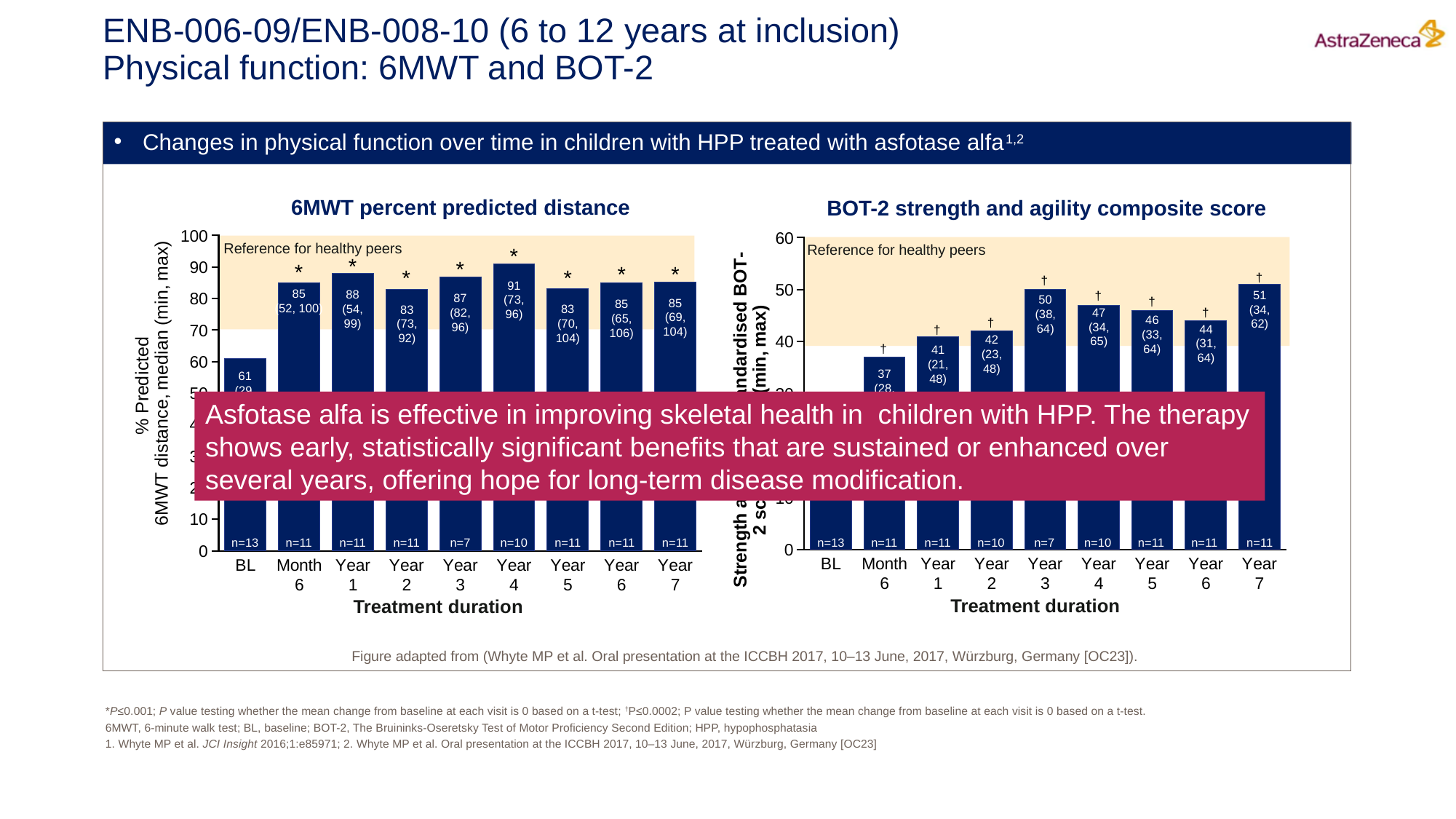
In the 6MWT percent predicted distance chart, which time point has the lowest median value? BL In the 6MWT percent predicted distance chart, what is the difference between the median at Year 4 and the median at baseline (BL)? 30 In the BOT-2 strength and agility composite score chart, which is larger, the median at Year 3 or the median at Year 6? Year 3 How many time points are shown on the x axis of the 6MWT percent predicted distance chart? 9 In the 6MWT percent predicted distance chart, what is the median value at Year 4? 91 In the BOT-2 strength and agility composite score chart, what is the median value at Year 7? 51 In the 6MWT percent predicted distance chart, what is the median value at baseline (BL)? 61 In the BOT-2 strength and agility composite score chart, what is the difference between the median at Year 3 and the median at Month 6? 13 In the 6MWT percent predicted distance chart, which time point has the highest median value? Year 4 What kind of chart is the BOT-2 strength and agility composite score chart? Bar chart In the BOT-2 strength and agility composite score chart, which labelled time point has the highest median value? Year 7 In the BOT-2 strength and agility composite score chart, what is the median value at Month 6? 37